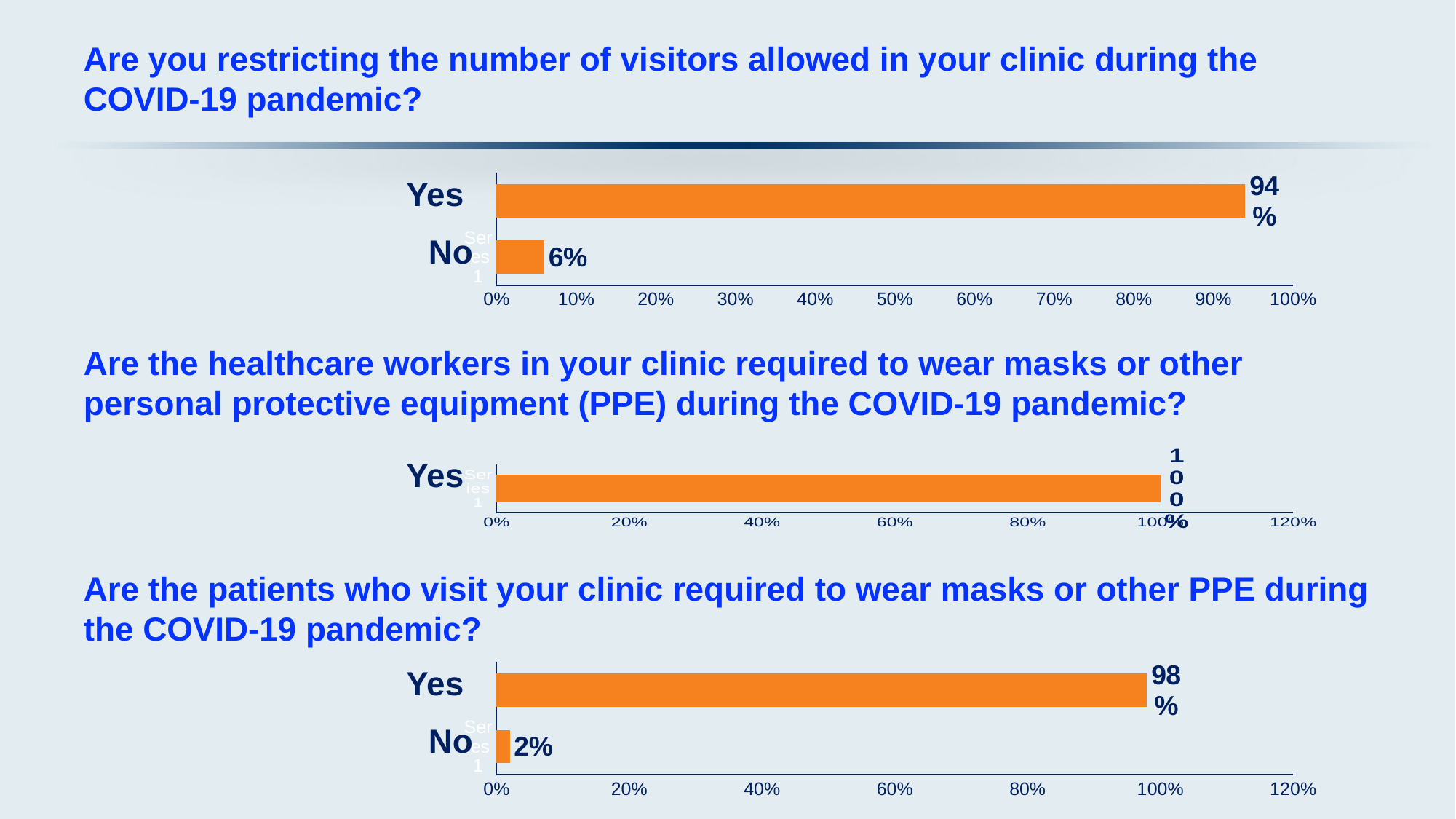
What type of chart is used for the top chart about restricting visitors? Bar chart In the top chart about restricting visitors, what is the difference between the Yes and No percentages? 88% In the top chart about restricting visitors, what percentage answered Yes? 94% In the middle chart about healthcare workers wearing masks or PPE, what percentage answered Yes? 100% In the top chart about restricting visitors, what percentage answered No? 6% Is the Yes value in the bottom chart about patients wearing masks or PPE larger than the Yes value in the top chart about restricting visitors? Yes How many categories are plotted in the middle chart about healthcare workers wearing masks or PPE? 1 How many charts are shown on the slide? 3 In the bottom chart about patients wearing masks or PPE, what percentage answered Yes? 98% In the top chart about restricting visitors, which category has the highest value? Yes In the bottom chart about patients wearing masks or PPE, what percentage answered No? 2% In the bottom chart about patients wearing masks or PPE, which category has the lowest value? No